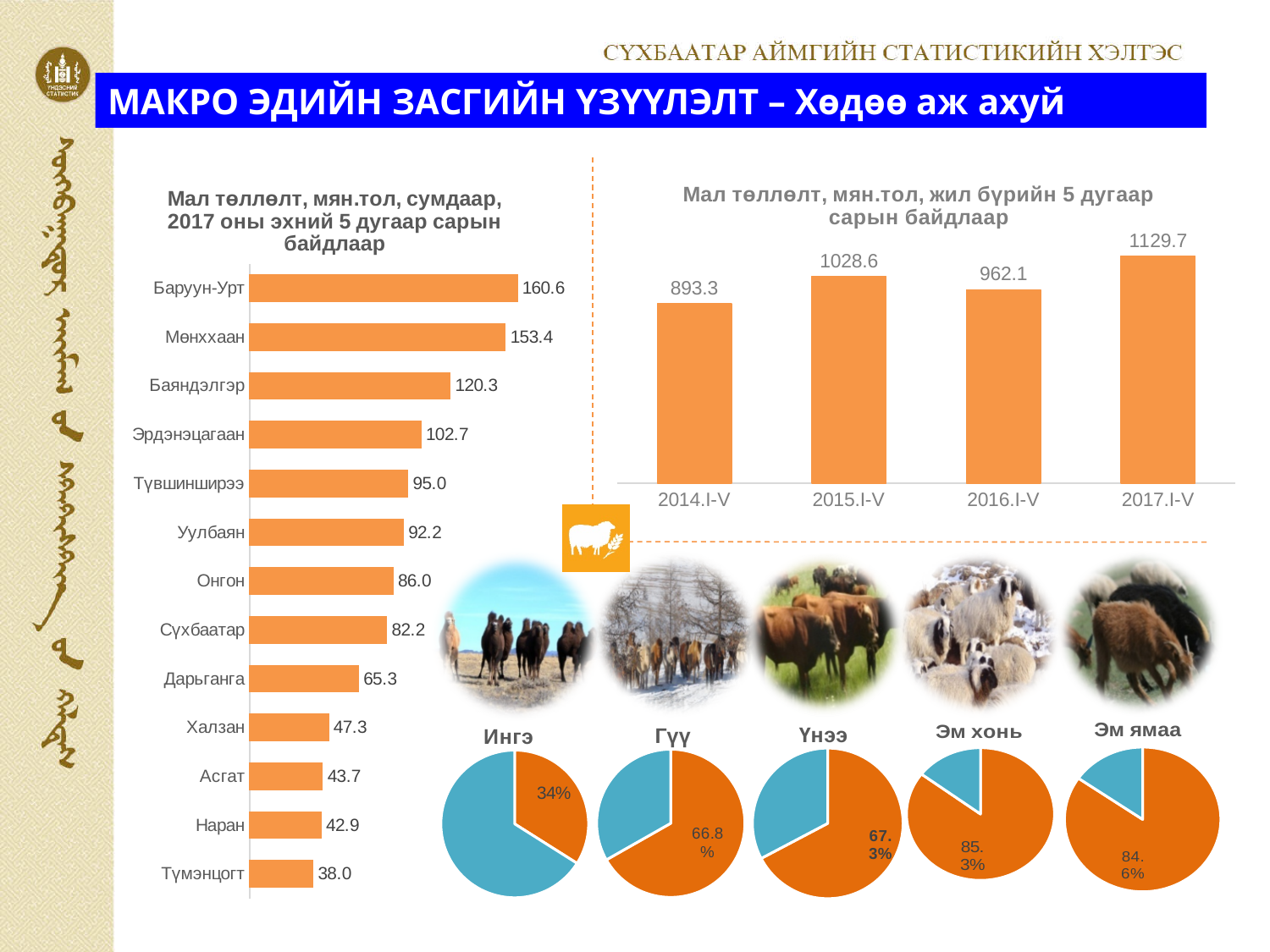
How many soums are shown in the left bar chart (Мал төллөлт, мян.тол, сумдаар)? 13 In the top-right chart (Мал төллөлт, мян.тол, жил бүрийн 5 дугаар сарын байдлаар), what is the difference between the values for 2015.I-V and 2014.I-V? 135.3 In the top-right chart (Мал төллөлт, мян.тол, жил бүрийн 5 дугаар сарын байдлаар), what is the value for 2017.I-V? 1129.7 In the pie chart titled 'Ингэ', what share is shown by the orange slice? 34% In the left bar chart (Мал төллөлт, мян.тол, сумдаар), what is the value for Баруун-Урт? 160.6 In the left bar chart (Мал төллөлт, мян.тол, сумдаар), what is the difference between the values for Баруун-Урт and Мөнххаан? 7.2 In the pie chart titled 'Эм хонь', what share is shown by the orange slice? 85.3% In the left bar chart (Мал төллөлт, мян.тол, сумдаар), which soum has the highest value? Баруун-Урт In the top-right chart (Мал төллөлт, мян.тол, жил бүрийн 5 дугаар сарын байдлаар), which period has the highest value? 2017.I-V In the left bar chart (Мал төллөлт, мян.тол, сумдаар), which is larger, the value for Онгон or for Сүхбаатар? Онгон In the left bar chart (Мал төллөлт, мян.тол, сумдаар), which soum has the lowest value? Түмэнцогт What kind of chart is the left chart titled 'Мал төллөлт, мян.тол, сумдаар'? Bar chart